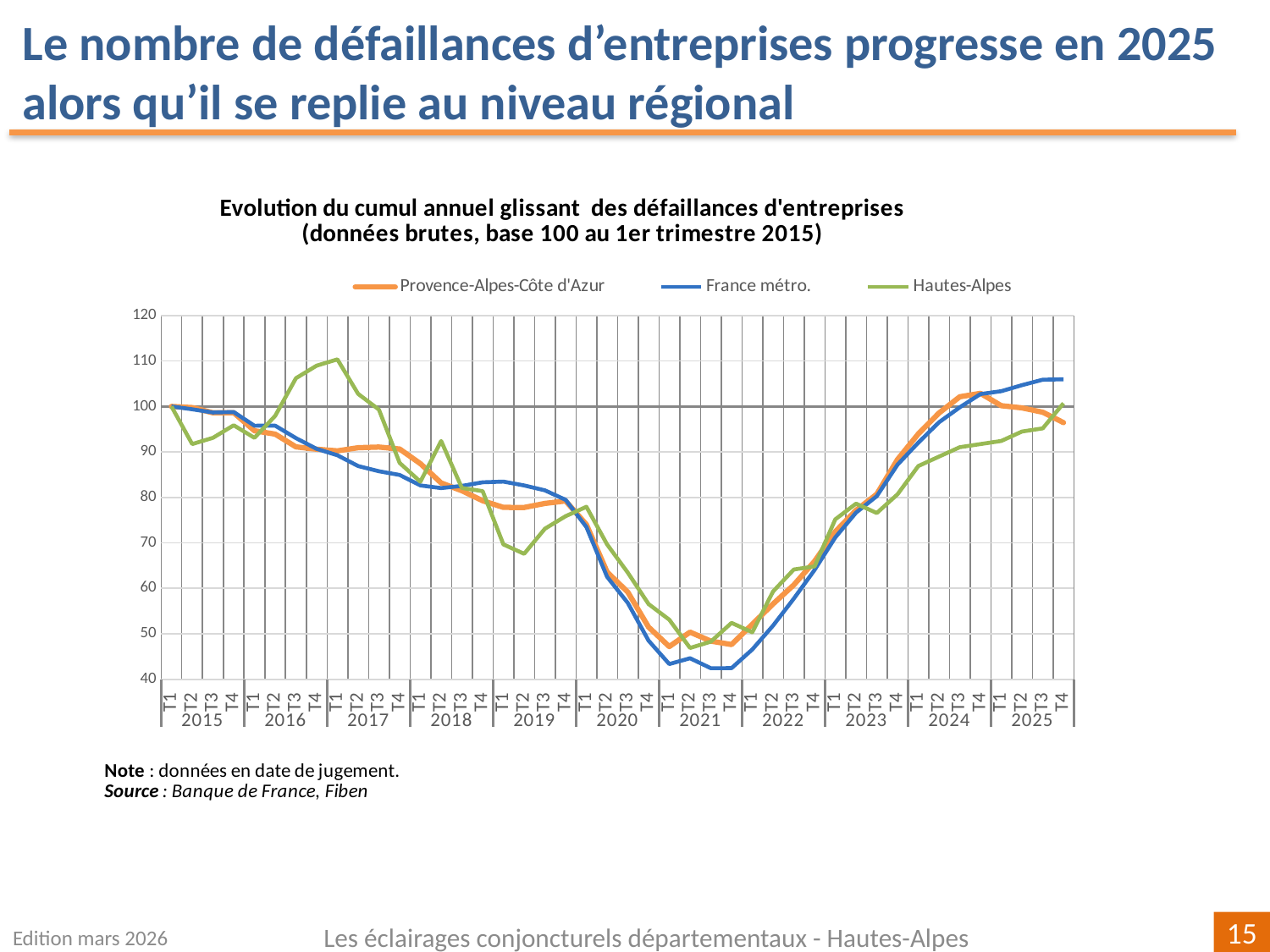
What is the value of the France métro. series at T1 2015? 100 Is the value for Provence-Alpes-Côte d'Azur at T4 2025 greater or less than 100? less Which series has the lowest value at T4 2021? France métro. How many series does the legend list? 3 Is the value for France métro. at T4 2025 greater or less than 100? greater What kind of chart is shown on the slide? line chart Is the value for France métro. at T4 2021 greater or less than 50? less Does the France métro. series rise or fall between T1 2021 and T4 2025? rise At T4 2025, which is higher: France métro. or Provence-Alpes-Côte d'Azur? France métro. What is the title of the chart? Evolution du cumul annuel glissant des défaillances d'entreprises (données brutes, base 100 au 1er trimestre 2015) Which series is drawn in blue? France métro.